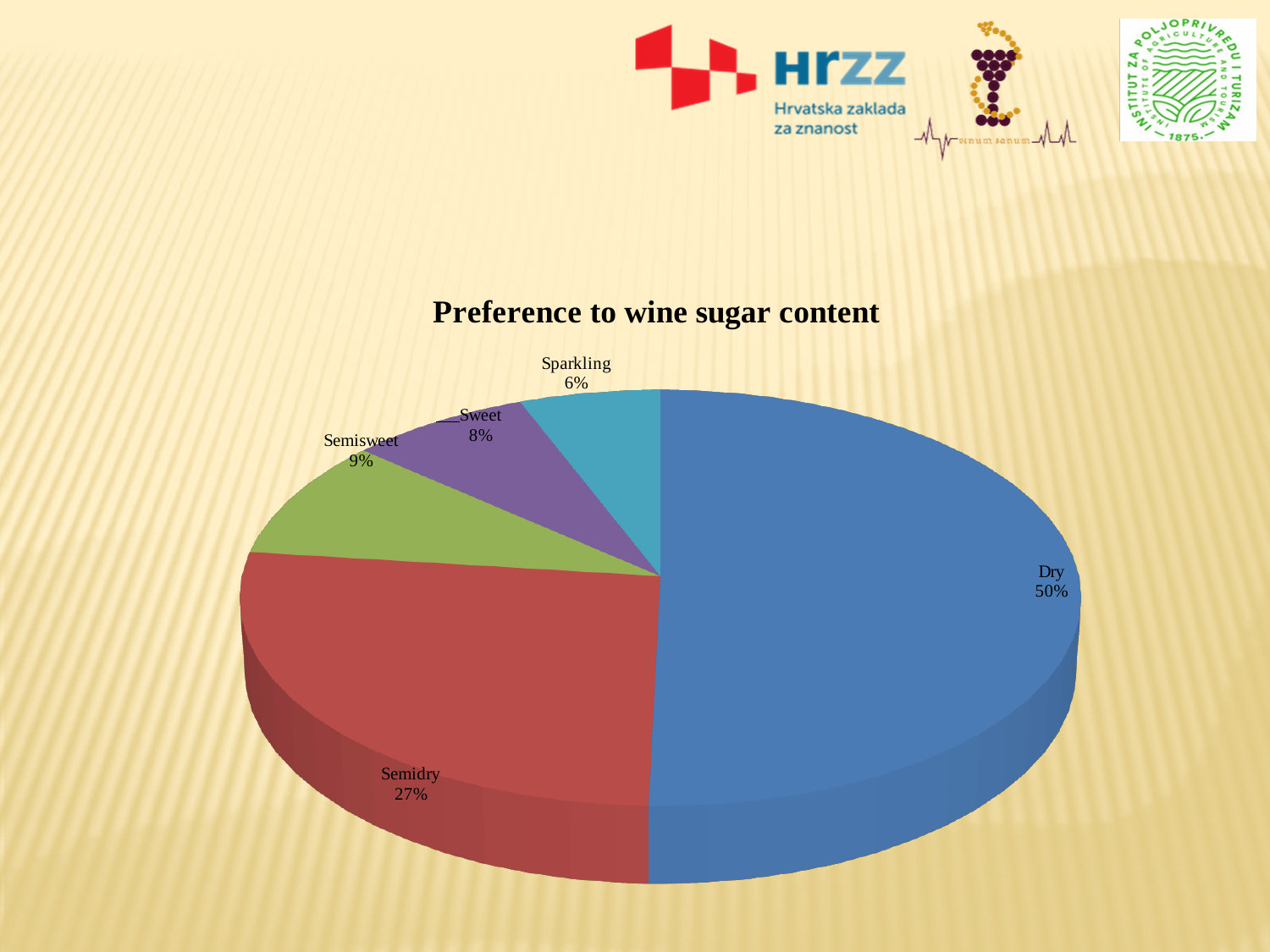
How many categories are shown in the pie chart? 5 What percentage is shown for Sweet? 8% What percentage is shown for Semisweet? 9% What kind of chart is shown on the slide? pie chart What percentage is shown for Sparkling? 6% Which category has the smallest slice of the pie? Sparkling What is the title of the chart? Preference to wine sugar content What percentage is shown for Semidry? 27% Which is larger, the share for Semisweet or the share for Sweet? Semisweet What is the difference in percentage points between Dry and Semidry? 23 Which category has the largest slice of the pie? Dry What share of the pie does Dry wine have? 50%